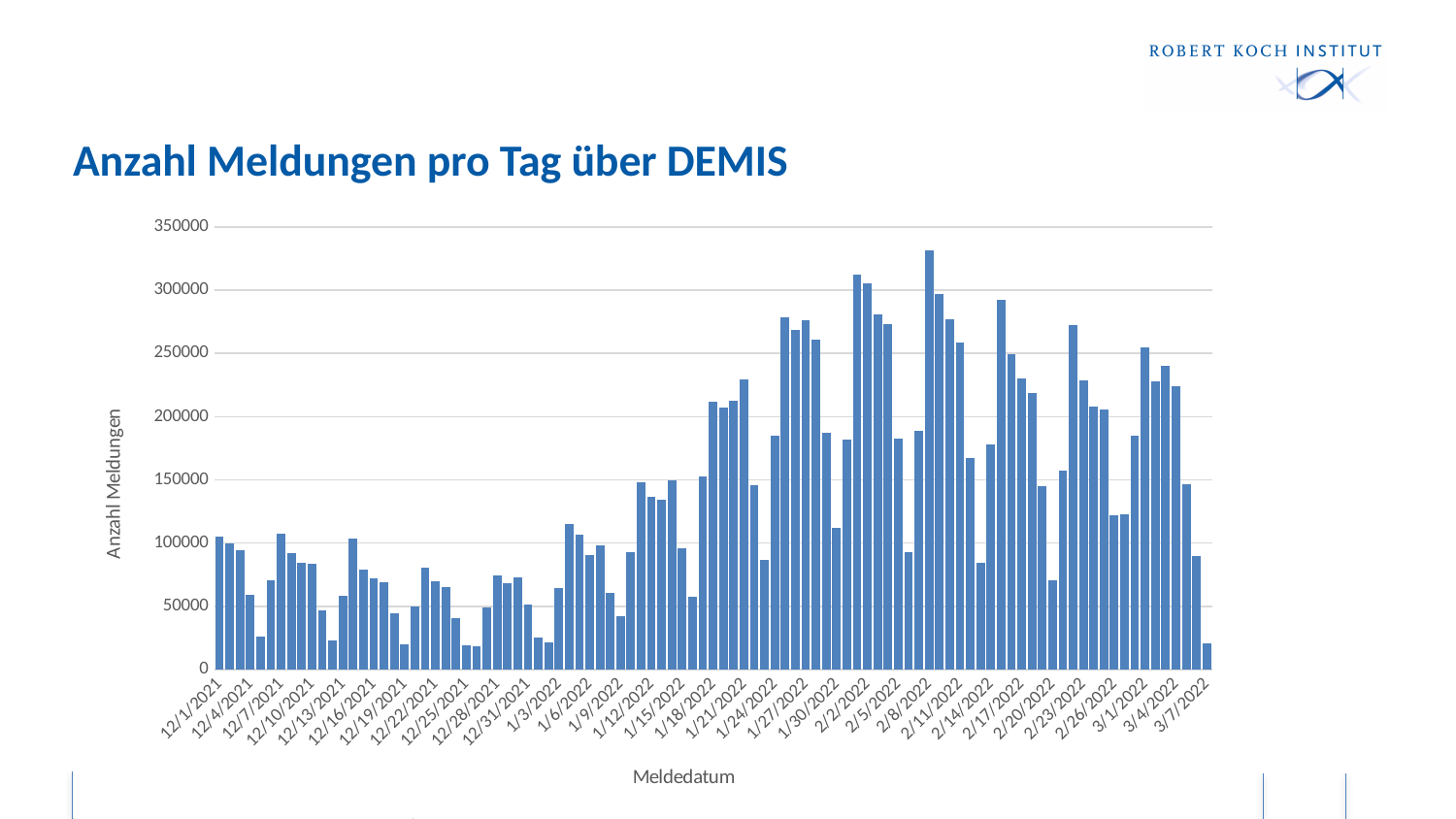
What kind of chart is shown on the slide? bar chart Is the value for 1/27/2022 greater or less than 250000? greater What is the label of the y axis? Anzahl Meldungen Which date has the highest bar in the chart? 2/8/2022 Is the value for 2/8/2022 greater or less than 300000? greater What is the title of the chart? Anzahl Meldungen pro Tag über DEMIS Which is larger, the value for 2/8/2022 or the value for 12/25/2021? 2/8/2022 Are the values in early December 2021 generally higher or lower than the values in early February 2022? lower Is the value for 12/25/2021 greater or less than 50000? less